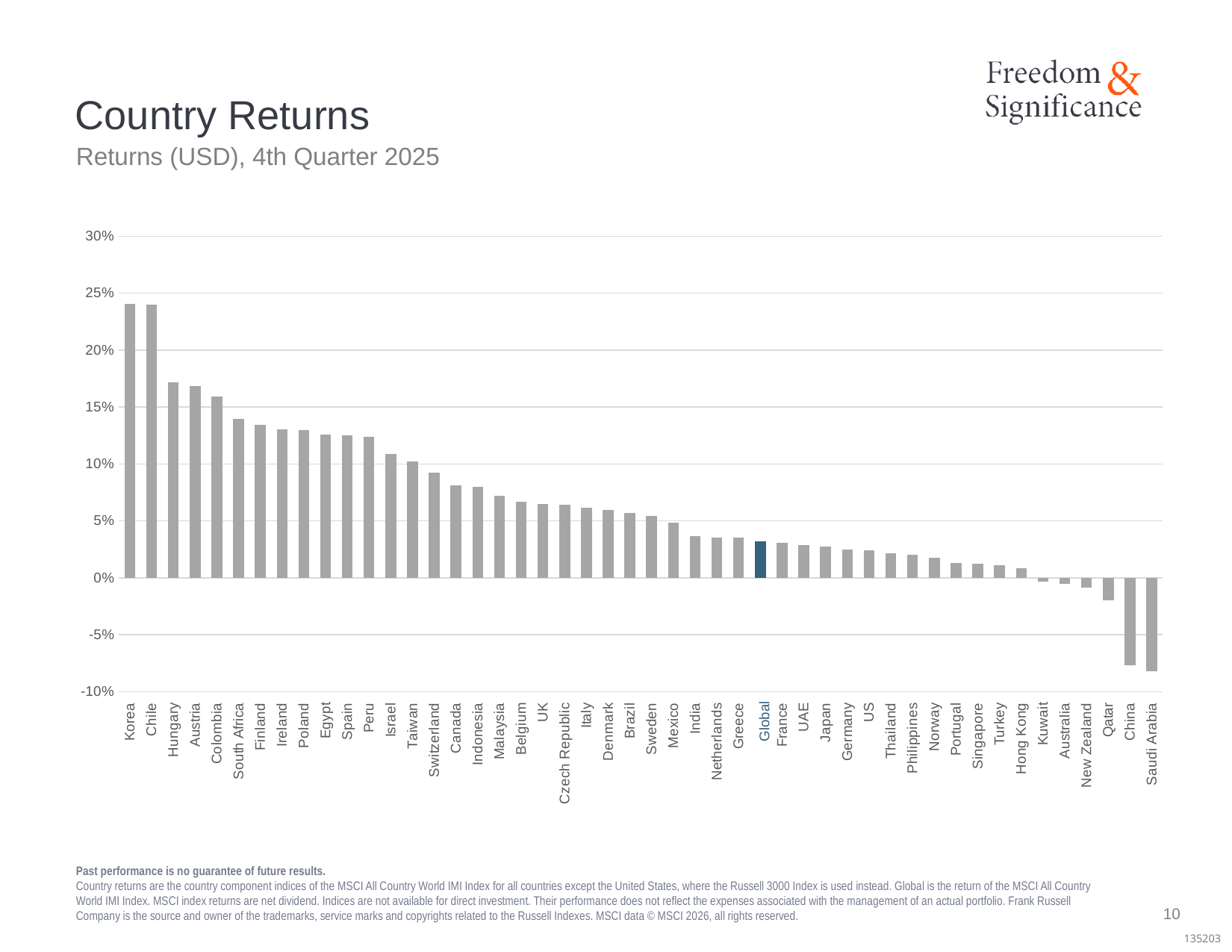
Is the value for Hungary greater or less than 15%? greater Is the value for China greater or less than -5%? less Which has the larger return, Brazil or Mexico? Brazil Do the values rise or fall moving from left to right along the x axis? Fall Which bar is highlighted in a dark blue colour, different from the other bars? Global What kind of chart is shown on the slide? Bar chart Is the value for Korea greater or less than 20%? greater How many bars (countries plus Global) are plotted in the chart? 48 Which has the larger return, Korea or Hungary? Korea